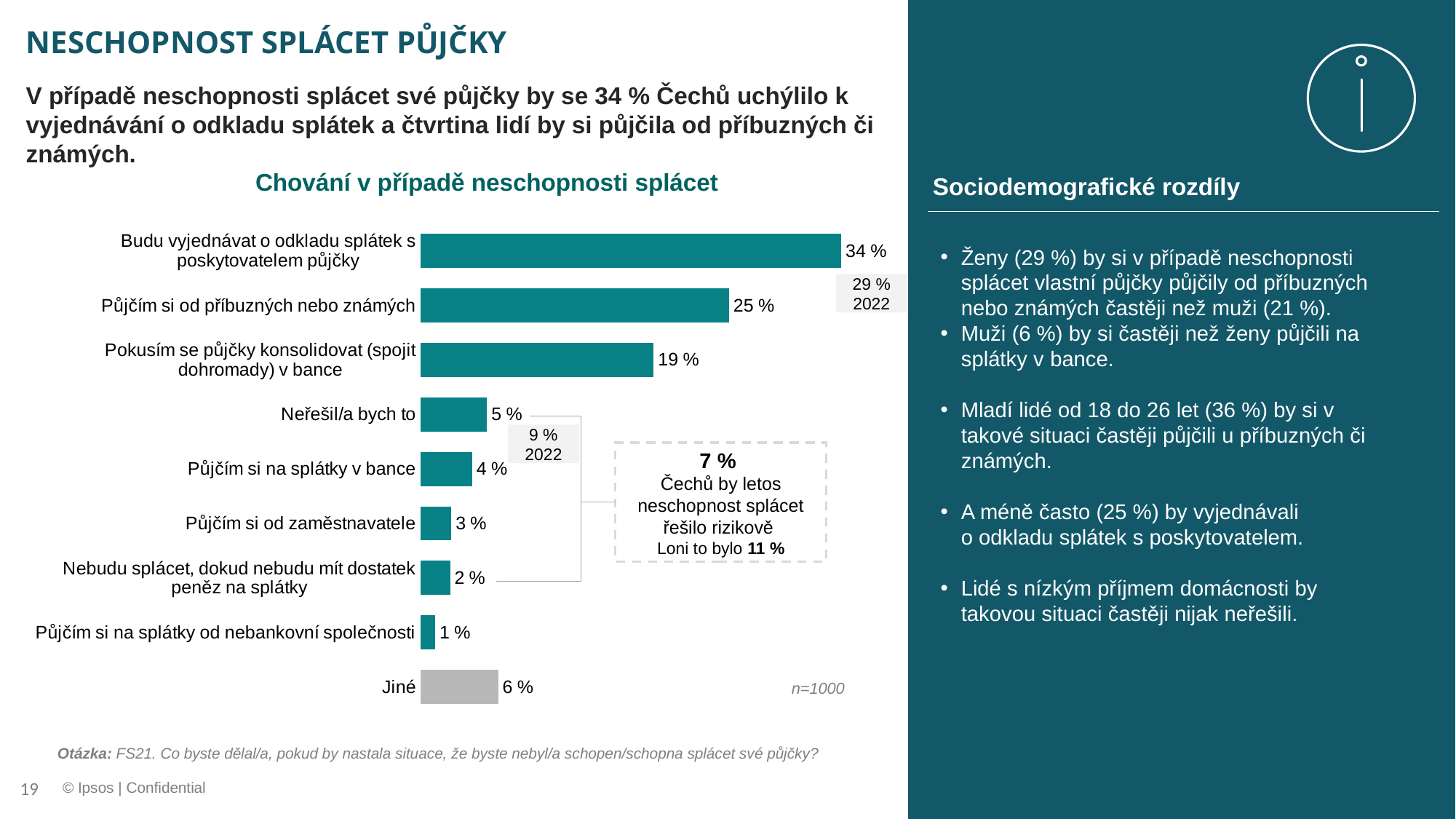
What is the difference between the values for "Budu vyjednávat o odkladu splátek s poskytovatelem půjčky" and "Půjčím si od příbuzných nebo známých"? 9 % Which is larger: the value for "Neřešil/a bych to" or the value for "Půjčím si na splátky v bance"? Neřešil/a bych to How many categories does the chart show? 9 What is the value for "Pokusím se půjčky konsolidovat (spojit dohromady) v bance"? 19 % What is the value for "Jiné"? 6 % What is the title of the chart? Chování v případě neschopnosti splácet Which category has the highest value? Budu vyjednávat o odkladu splátek s poskytovatelem půjčky What is the value for "Budu vyjednávat o odkladu splátek s poskytovatelem půjčky"? 34 % What is the value for "Půjčím si od příbuzných nebo známých"? 25 % Which category has the lowest value? Půjčím si na splátky od nebankovní společnosti What kind of chart is shown on the slide? Bar chart What is the value for "Půjčím si na splátky od nebankovní společnosti"? 1 %